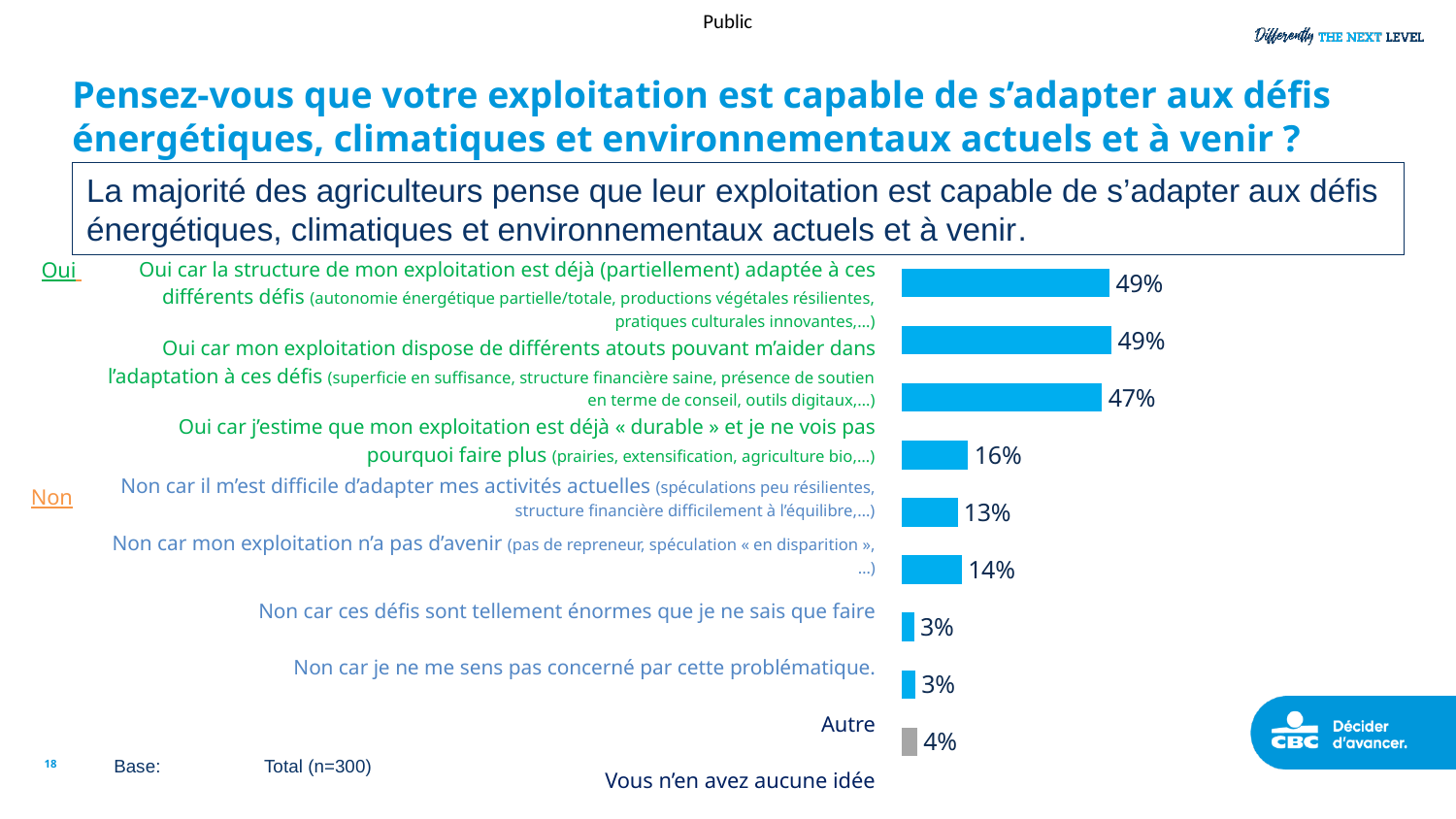
What is the value for 'Oui car la structure de mon exploitation est déjà (partiellement) adaptée à ces différents défis'? 49% What is the highest value shown in the chart? 49% What is the difference between the highest value (49%) and the value for 'Autre' (3%)? 46 percentage points What is the value for 'Autre'? 3% How many bars in the chart show a value of 49%? 2 What is the value for 'Vous n'en avez aucune idée'? 4% What is the value for 'Non car je ne me sens pas concerné par cette problématique'? 3% How many bars in the chart have a value above 40%? 3 What is the lowest value shown in the chart? 3% How many bars does the chart contain? 9 What kind of chart is shown on the slide? Bar chart What is the base (sample size) stated for the chart? Total (n=300)